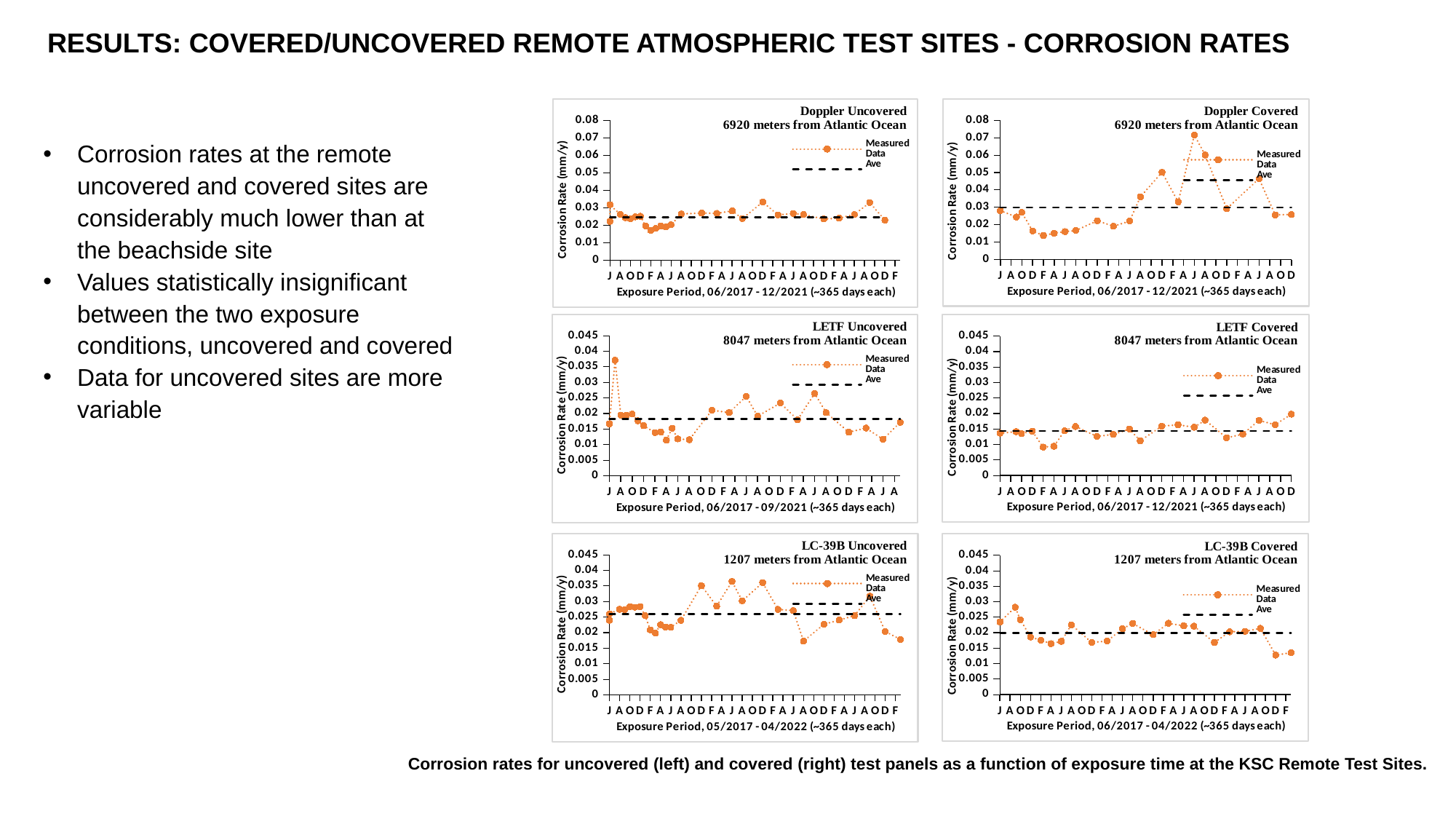
What kind of chart is the Doppler Uncovered chart? line chart According to the LETF Uncovered chart title, how far is the LETF site from the Atlantic Ocean? 8047 meters What exposure period is shown on the x-axis of the LC-39B Uncovered chart? 05/2017 - 04/2022 (~365 days each) In the Doppler Covered chart, is the first measured data point greater or less than 0.02? greater In the LETF Uncovered chart, is the highest measured data point greater or less than 0.03? greater In the LC-39B Covered chart, is the lowest measured data point greater or less than 0.015? less Which chart has the higher Ave line: LC-39B Uncovered or LC-39B Covered? LC-39B Uncovered How many series does the legend of the LETF Covered chart list? 2 In the LC-39B Covered chart, do the measured values overall rise or fall from the start to the end of the exposure period? fall